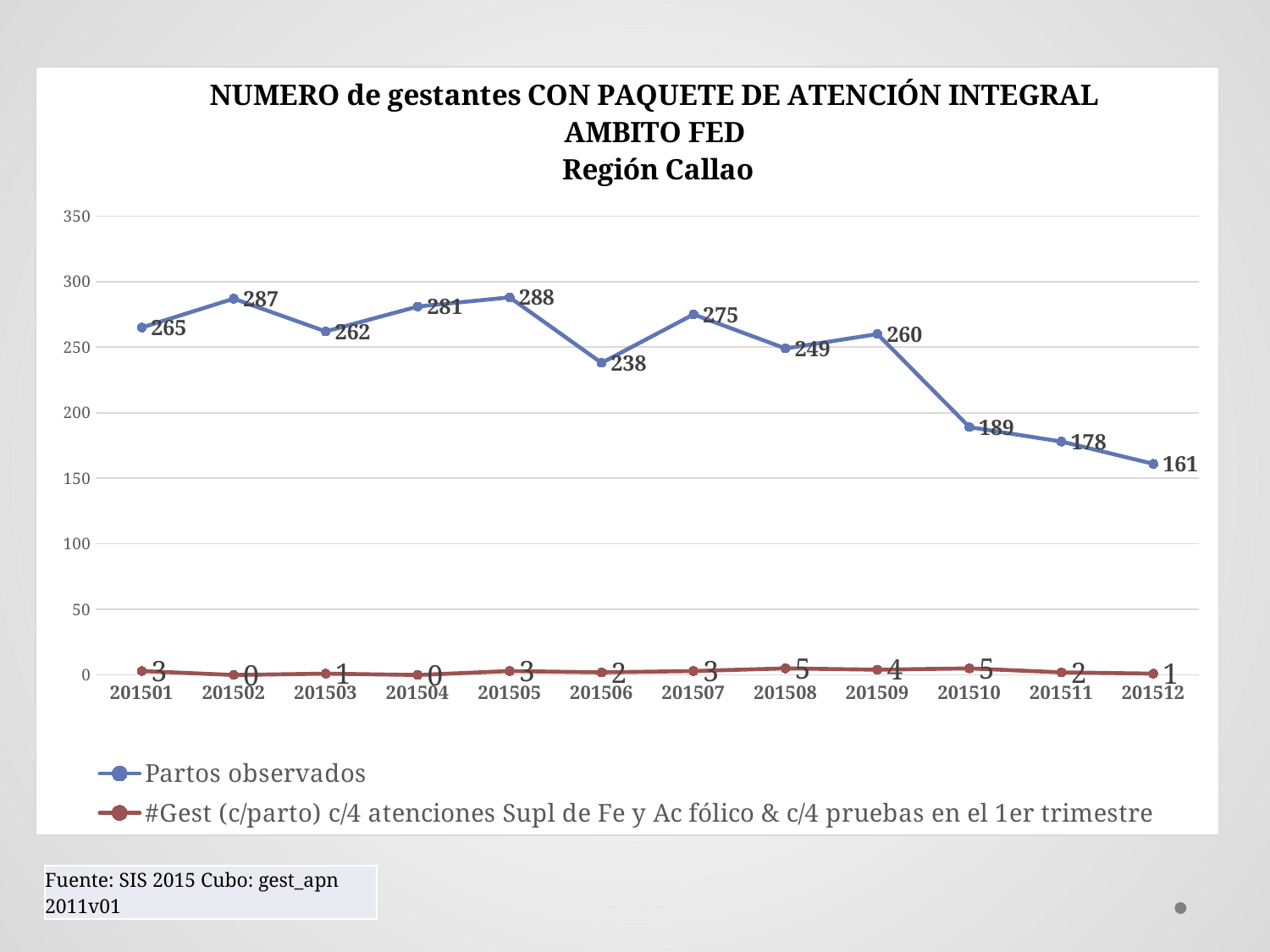
Which is larger, Partos observados in 201502 or in 201506? 201502 What is the value of the series '#Gest (c/parto) c/4 atenciones Supl de Fe y Ac fólico & c/4 pruebas en el 1er trimestre' for 201508? 5 Does Partos observados rise or fall from 201509 to 201512? fall How many months are shown on the x axis? 12 In which month is Partos observados lowest? 201512 Which region is named in the chart title? Región Callao What is the value of Partos observados for 201505? 288 What is the value of Partos observados for 201512? 161 What is the difference between Partos observados in 201509 and 201510? 71 In which month is Partos observados highest? 201505 How many series does the legend list? 2 What type of chart is shown on the slide? line chart